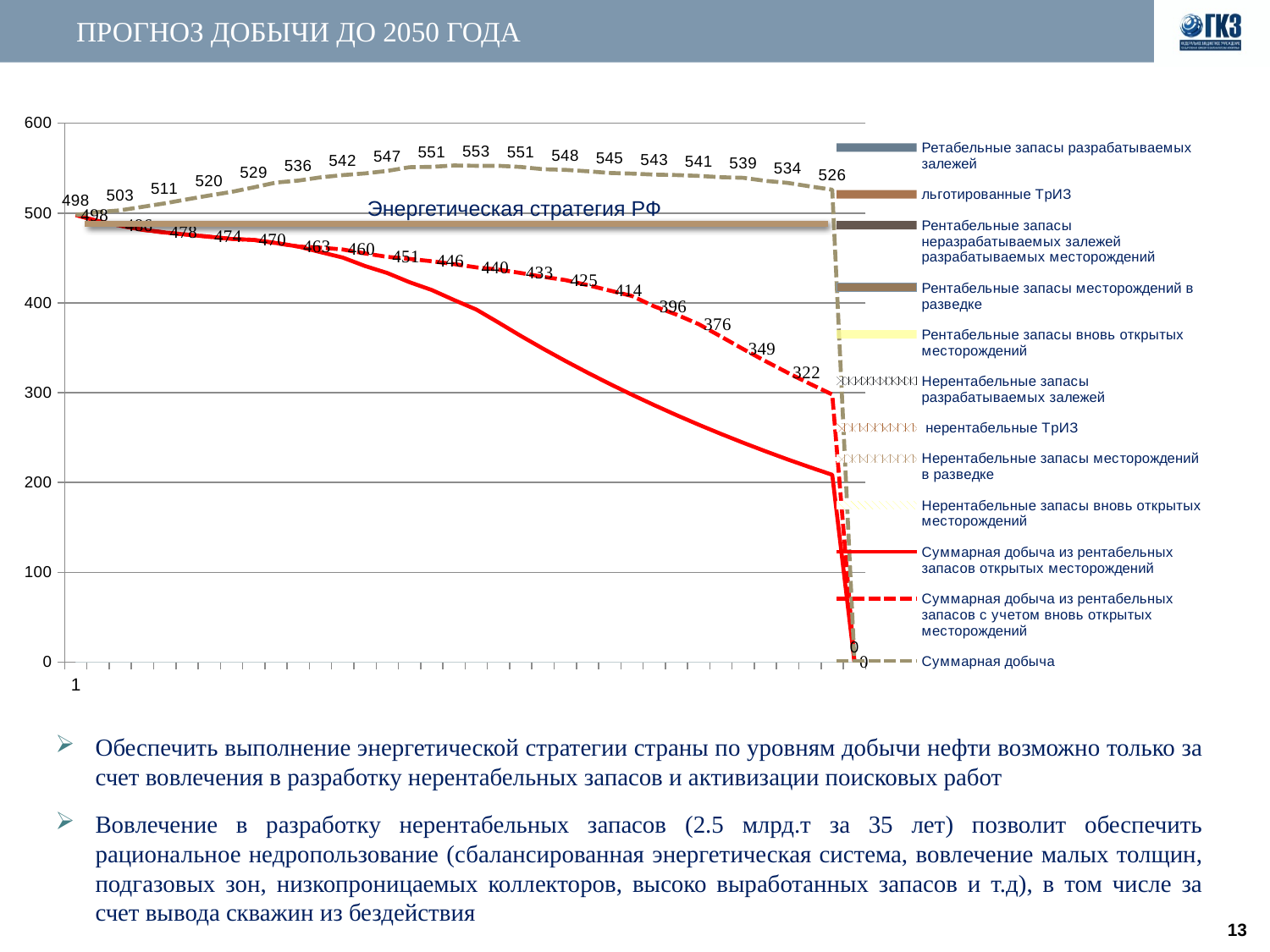
What kind of chart is shown on the slide? Line chart What is the first labelled value of the 'Суммарная добыча' line? 498 What is the last labelled value of the 'Суммарная добыча' line before it drops to 0? 526 What is the difference between the peak value (553) and the starting value (498) of the 'Суммарная добыча' line? 55 Is the value of the solid red line ('Суммарная добыча из рентабельных запасов открытых месторождений') just before it drops to zero greater or less than 300? less What is the difference between the final labelled values of the 'Суммарная добыча' line (526) and the red dashed line (322)? 204 What is the last labelled value of the red dashed line ('Суммарная добыча из рентабельных запасов с учетом вновь открытых месторождений') before it drops to 0? 322 Which is larger on the red dashed line: the labelled value 414 or the labelled value 396? 414 How many entries does the legend list? 12 What text label is written across the chart near the 500 level? Энергетическая стратегия РФ What is the highest labelled value on the dashed 'Суммарная добыча' line? 553 Does the red dashed line rise or fall along the x axis? Fall